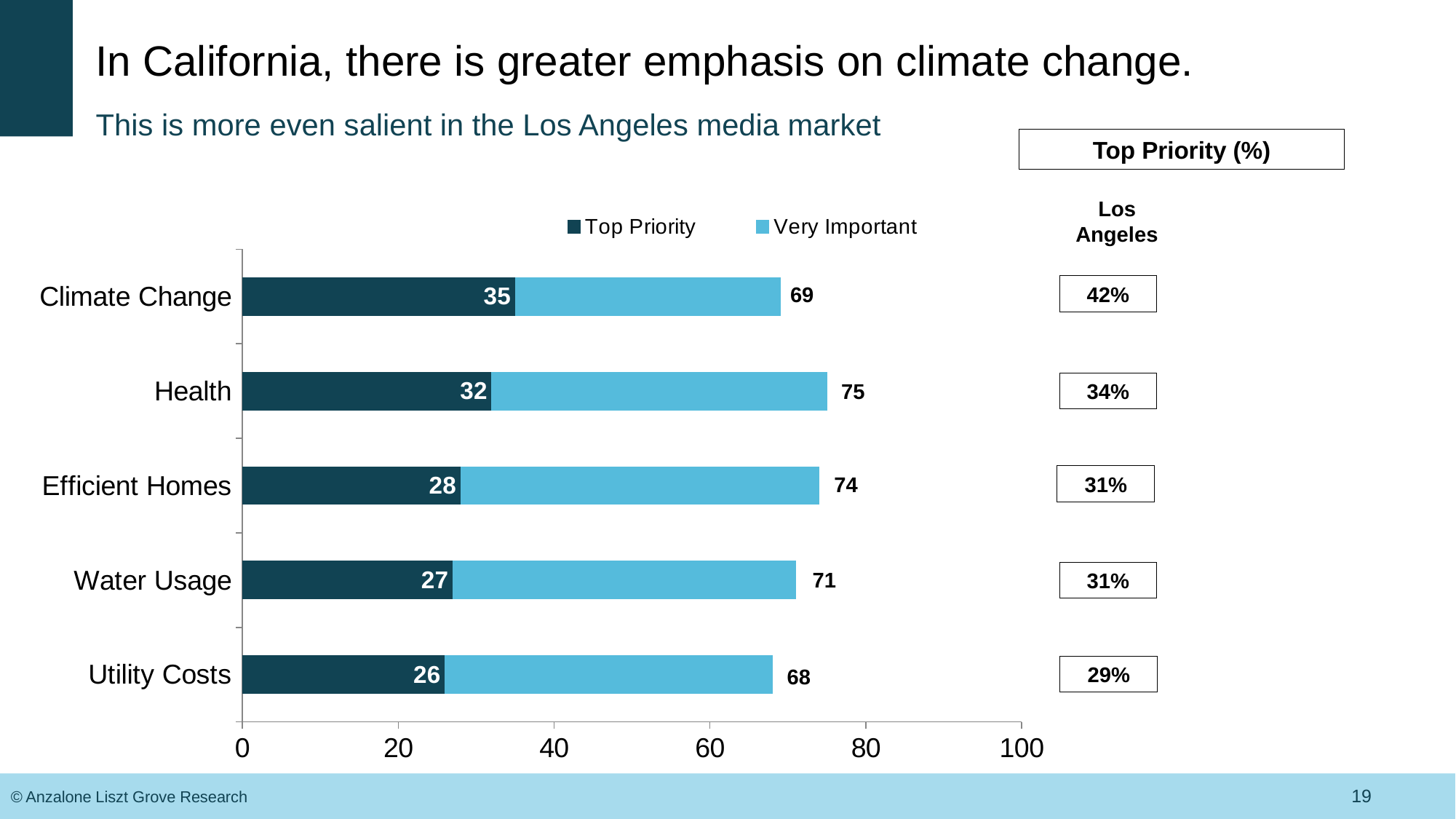
Which has a larger total bar value, Efficient Homes or Water Usage? Efficient Homes What is the total value labeled at the end of the Water Usage bar? 71 What is the Top Priority value for Utility Costs? 26 How many series does the legend list? 2 What is the Top Priority value for Climate Change? 35 What kind of chart is shown on the slide? Stacked bar chart What is the difference between the Top Priority values for Climate Change and Health? 3 Which category has the highest Top Priority value? Climate Change Which category has the lowest total bar value? Utility Costs How many categories are shown on the chart? 5 What is the total value labeled at the end of the Health bar? 75 In the Top Priority (%) table, what is the Los Angeles value for Climate Change? 42%